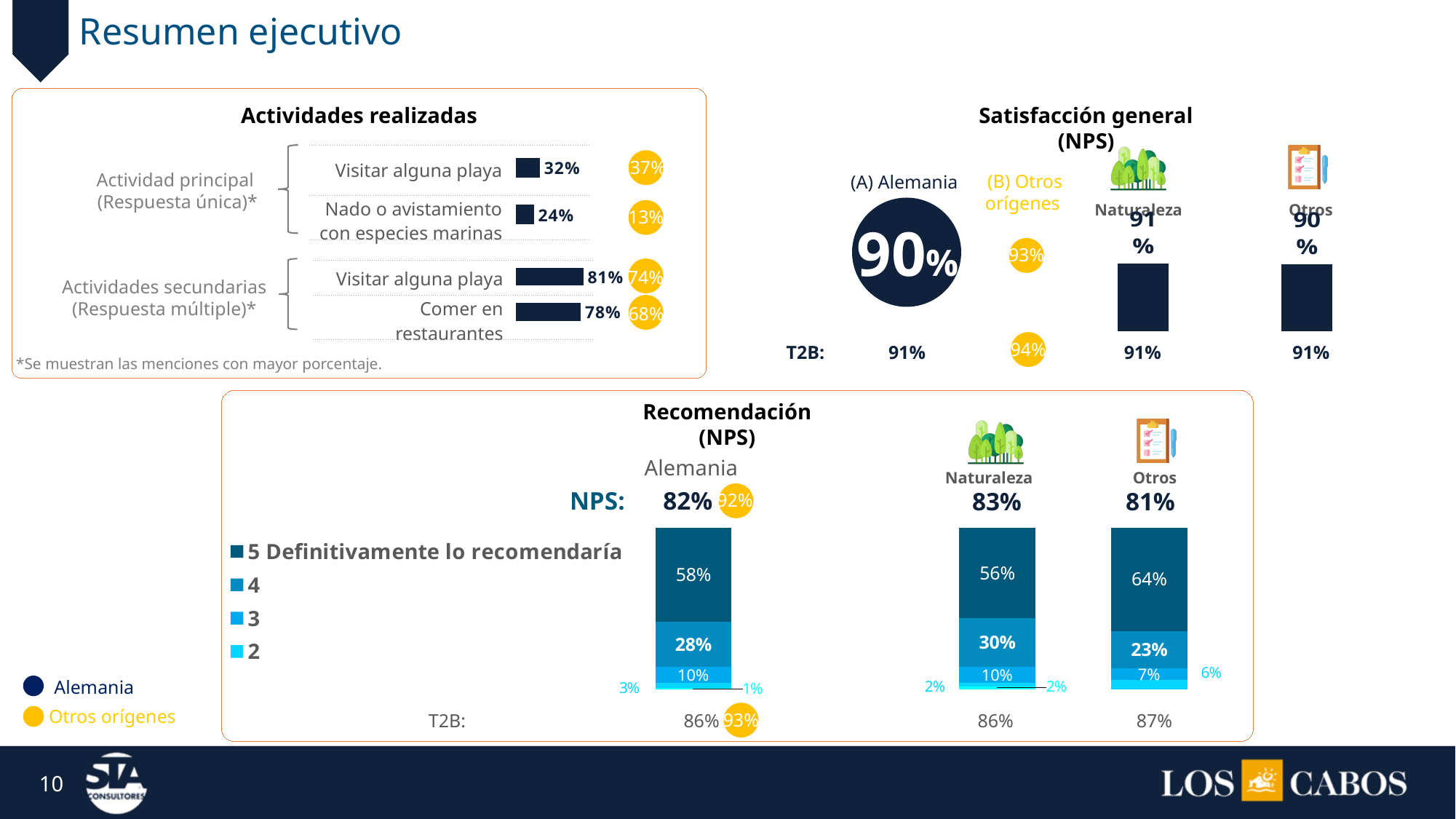
In the 'Actividades realizadas' chart, what is the value for 'Visitar alguna playa' under Actividad principal? 32% In the 'Actividades realizadas' chart, which activity has the highest bar value? Visitar alguna playa (Actividades secundarias) In the 'Actividades realizadas' chart, what kind of chart is used? Bar chart In the 'Recomendación (NPS)' chart, what is the share of '5 Definitivamente lo recomendaría' for Otros? 64% In the 'Recomendación (NPS)' chart, what is the NPS value for Naturaleza? 83% In the 'Satisfacción general (NPS)' chart, what is the T2B value for (A) Alemania? 91% In the 'Satisfacción general (NPS)' chart, what is the value for Naturaleza? 91% In the 'Recomendación (NPS)' chart, which segment has the highest NPS: Alemania, Naturaleza or Otros? Naturaleza In the 'Actividades realizadas' chart, what is the value for 'Comer en restaurantes'? 78% In the 'Recomendación (NPS)' chart, how many stacked bars are shown? 3 In the 'Actividades realizadas' chart, what is the difference between 'Visitar alguna playa' (81%) and 'Comer en restaurantes' (78%) under Actividades secundarias? 3% In the 'Recomendación (NPS)' chart, is the '4' segment larger for Alemania or for Otros? Alemania